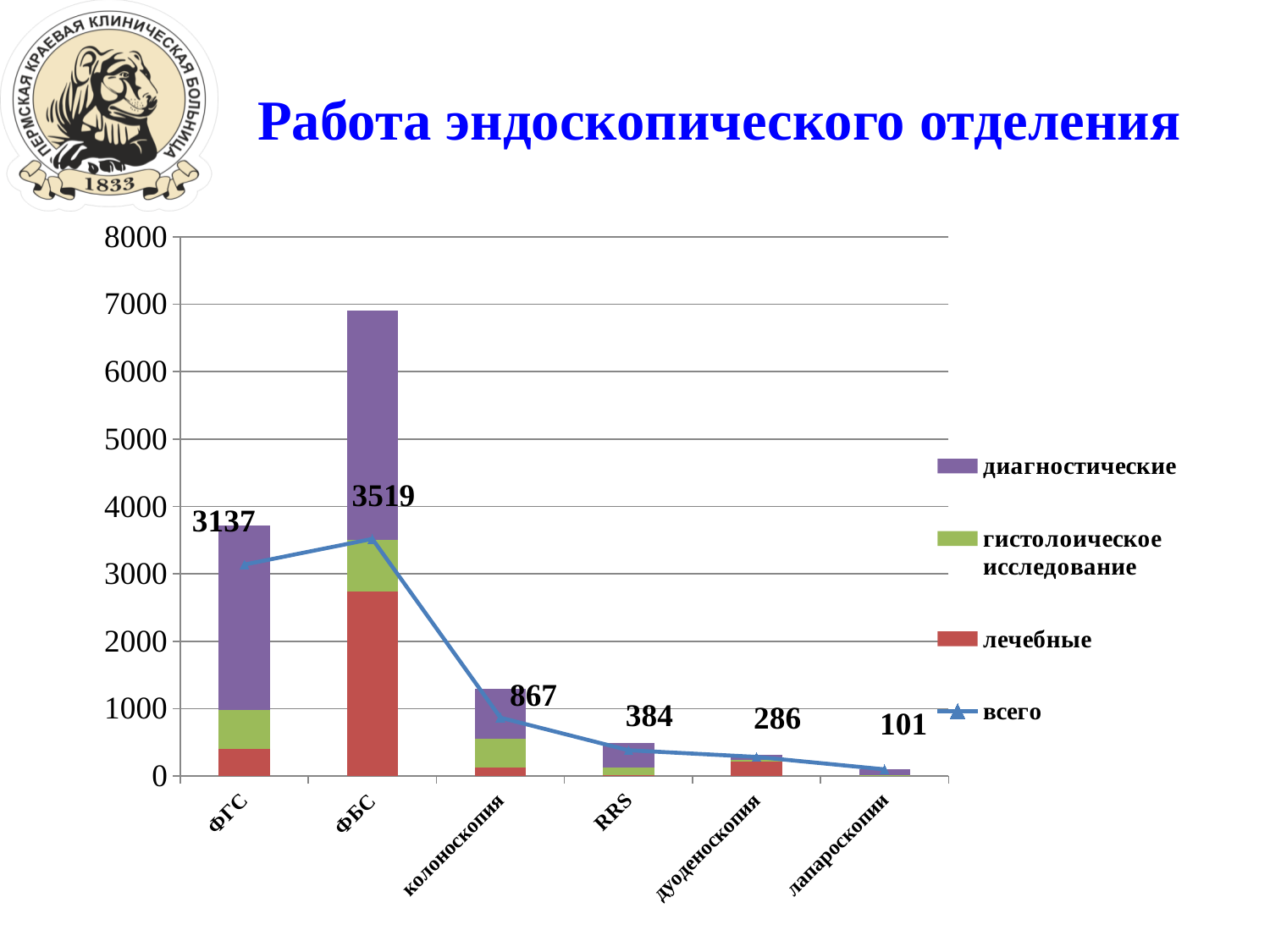
What is the value of the "всего" line for колоноскопия? 867 Which category has the lowest "всего" value? лапароскопии What kind of chart is shown on the slide? A stacked bar chart combined with a line Which has a larger "всего" value, RRS or дуоденоскопия? RRS What is the value of the "всего" line for ФГС? 3137 What is the difference between the "всего" values for ФБС and ФГС? 382 Which category has the highest "всего" value? ФБС Does the "всего" line rise or fall from колоноскопия to лапароскопии? It falls Is the total height of the stacked bar for ФБС greater or less than 6000? greater How many categories are shown on the x axis? 6 How many series does the legend list? 4 What is the value of the "всего" line for дуоденоскопия? 286